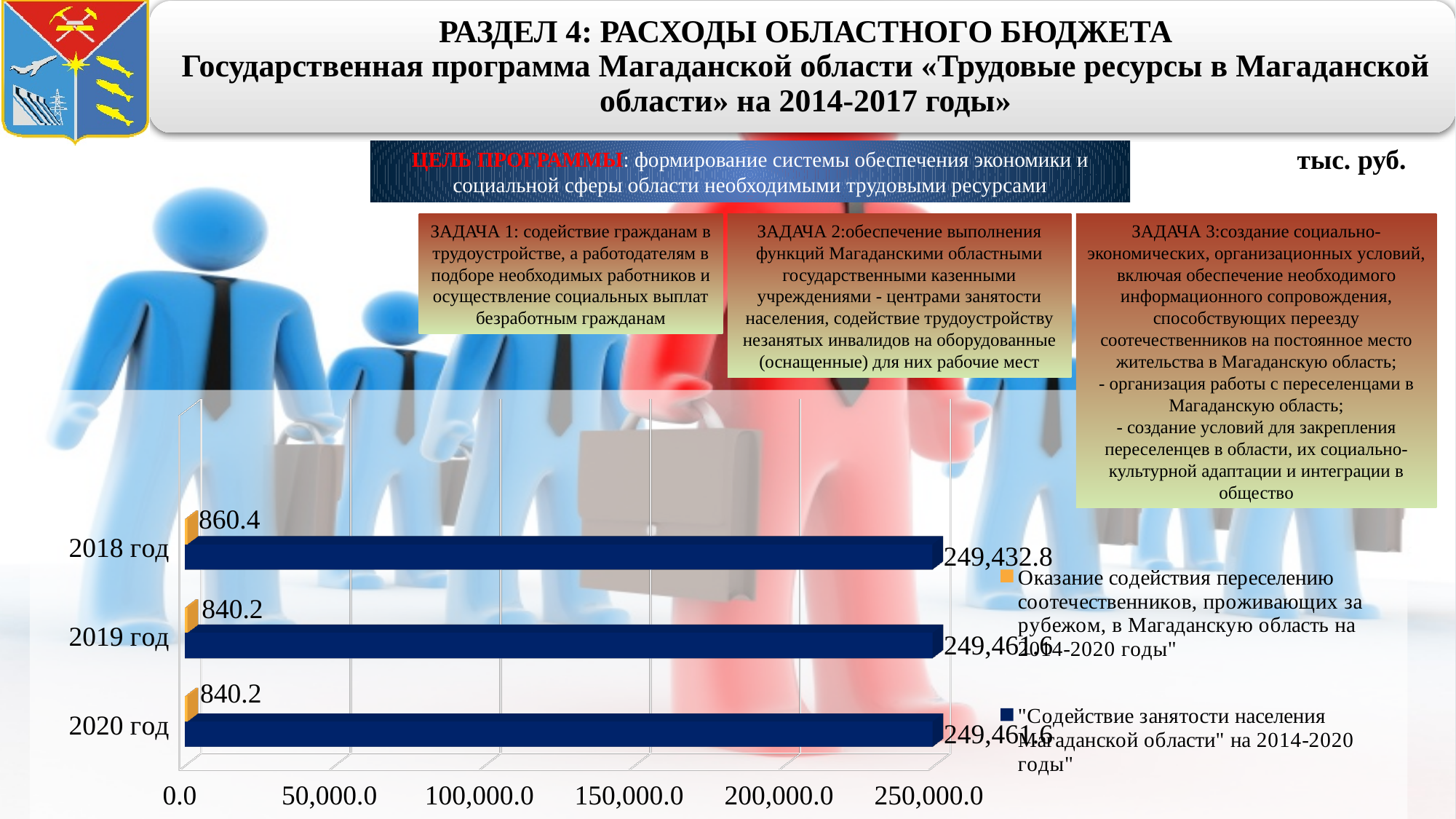
Which year has the highest value for the series "Оказание содействия переселению соотечественников"? 2018 год Which year has the lowest value for the series "Содействие занятости населения Магаданской области"? 2018 год What unit of measurement is indicated for the chart values? тыс. руб. What is the value for 2019 год for the series "Содействие занятости населения Магаданской области" на 2014-2020 годы"? 249,461.6 Is the value for 2020 год for the series "Содействие занятости населения Магаданской области" greater or less than 200,000.0? greater What is the value for 2018 год for the series "Содействие занятости населения Магаданской области" на 2014-2020 годы"? 249,432.8 What is the value for 2020 год for the series "Оказание содействия переселению соотечественников, проживающих за рубежом, в Магаданскую область на 2014-2020 годы"? 840.2 What is the difference between the 2018 год and 2019 год values for the series "Оказание содействия переселению соотечественников"? 20.2 What is the value for 2018 год for the series "Оказание содействия переселению соотечественников, проживающих за рубежом, в Магаданскую область на 2014-2020 годы"? 860.4 How many series does the chart legend list? 2 What kind of chart is shown on the slide? bar chart How many year categories are shown on the chart? 3